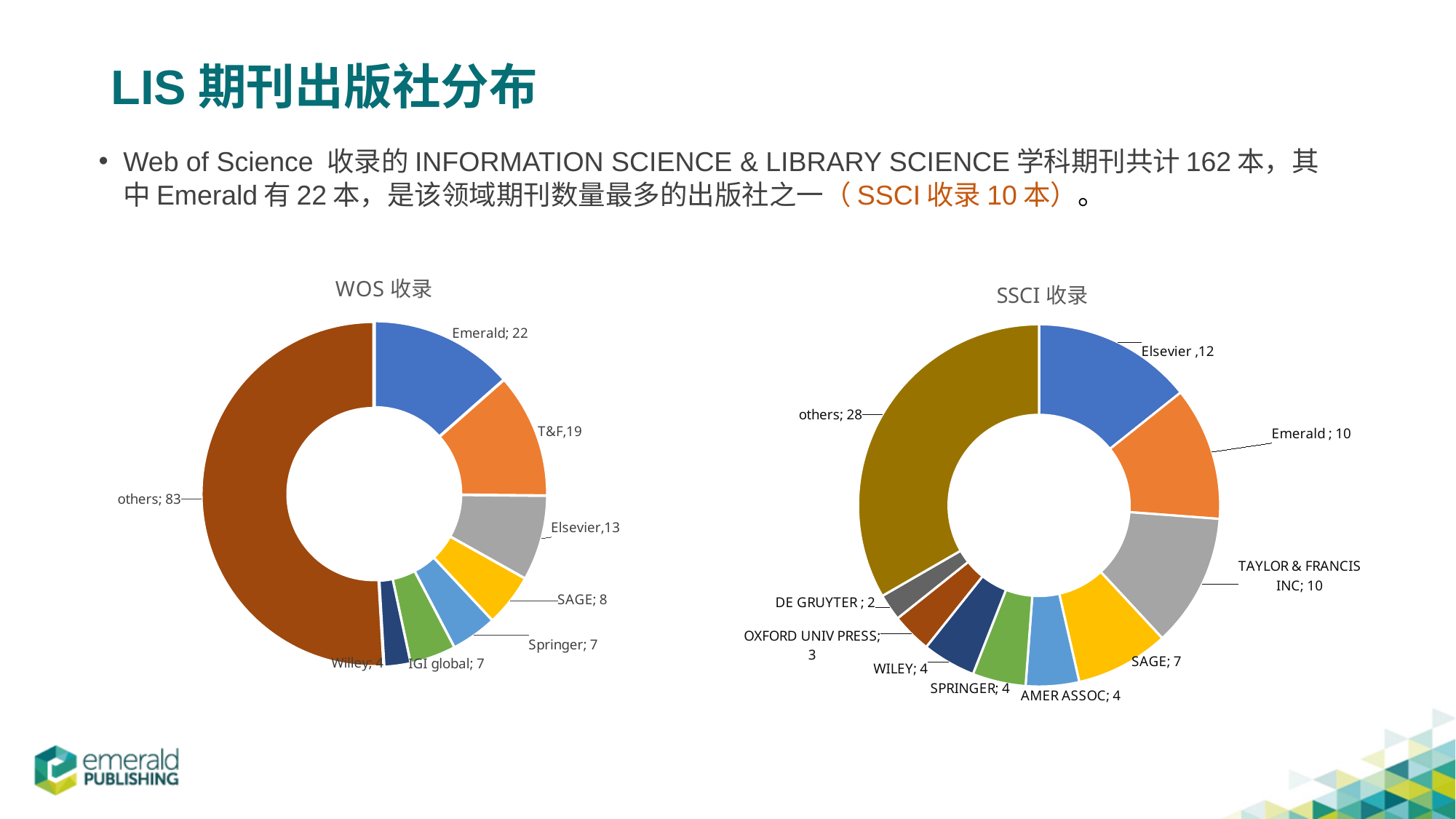
In the SSCI 收录 chart, what is the value for Elsevier? 12 In the SSCI 收录 chart, what is the difference between others and Elsevier? 16 What is the title of the chart on the right side of the slide? SSCI 收录 In the WOS 收录 chart, which is larger, SAGE or Springer? SAGE In the SSCI 收录 chart, which named publisher (excluding others) has the smallest value? DE GRUYTER In the WOS 收录 chart, which category has the largest value? others In the WOS 收录 chart, what is the difference between Emerald and Elsevier? 9 In the WOS 收录 chart, what is the value for T&F? 19 How many categories are shown in the SSCI 收录 chart? 10 What type of chart is the WOS 收录 chart? Doughnut chart In the SSCI 收录 chart, what is the value for OXFORD UNIV PRESS? 3 In the WOS 收录 chart, how many journals does Emerald have? 22